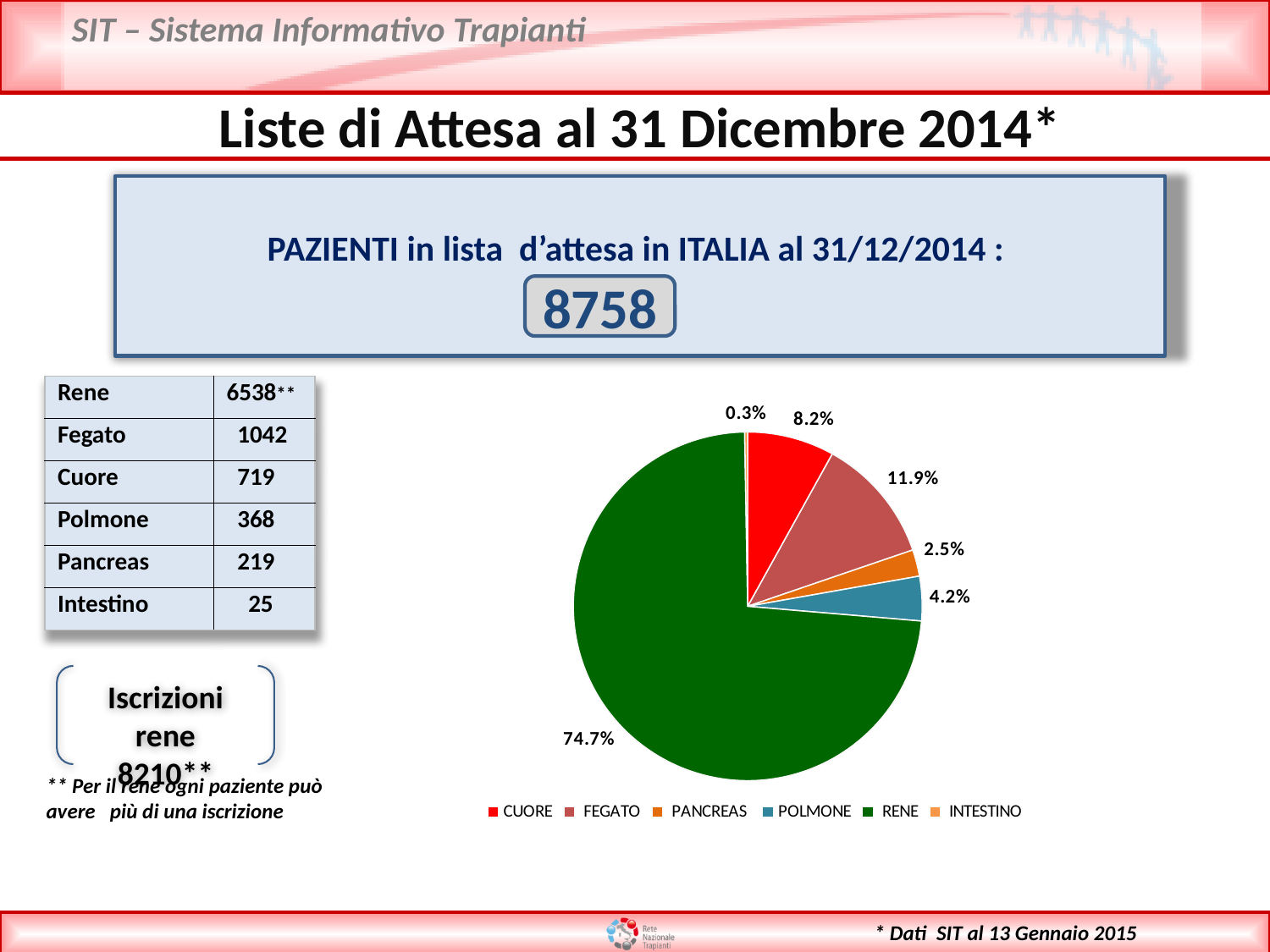
Which slice is larger in the pie chart, FEGATO or CUORE? FEGATO What share of the pie chart does PANCREAS represent? 2.5% Which category has the smallest slice in the pie chart? INTESTINO What share of the pie chart does INTESTINO represent? 0.3% What share of the pie chart does RENE represent? 74.7% Which category has the largest slice in the pie chart? RENE How many categories does the pie chart legend list? 6 What is the difference in percentage points between the FEGATO and POLMONE slices? 7.7 What type of chart is shown on the slide? pie chart